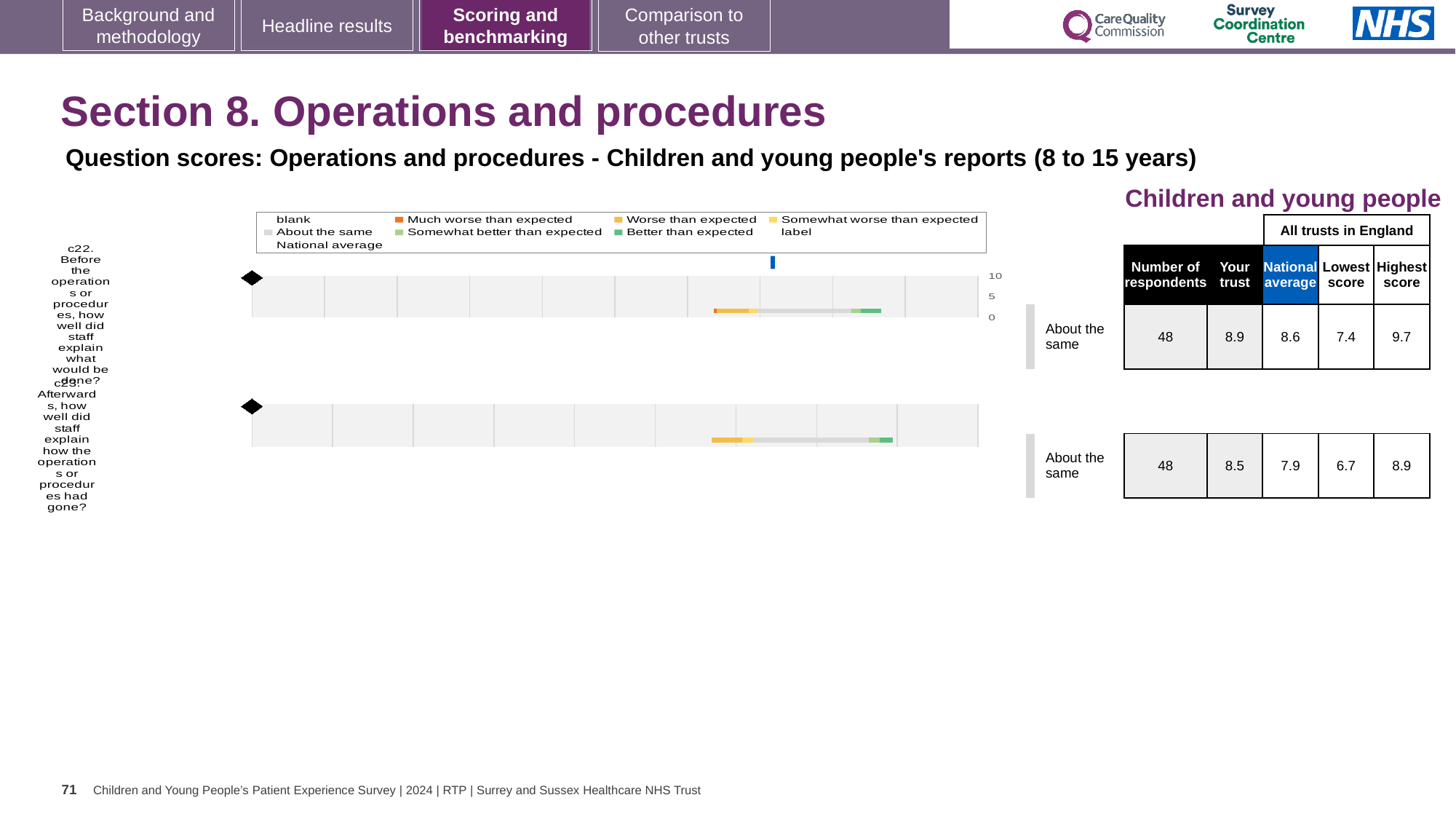
What benchmark category is shown for question c22? About the same For question c22 (Before the operations or procedures, how well did staff explain what would be done?), what is the 'Your trust' score? 8.9 For question c22, what is the Highest score among all trusts in England? 9.7 For question c23, what is the difference between the 'Your trust' score and the National average? 0.6 For question c23 (Afterwards, how well did staff explain how the operations or procedures had gone?), what is the 'Your trust' score? 8.5 For question c23, which is larger: the 'Your trust' score or the National average? Your trust For question c22, what is the National average score? 8.6 What kind of chart is used to show the question scores for c22 and c23? bar chart For question c23, what is the National average score? 7.9 How many respondents answered question c22? 48 For question c23, what is the Lowest score among all trusts in England? 6.7 How many survey questions (chart rows) are plotted on the slide? 2